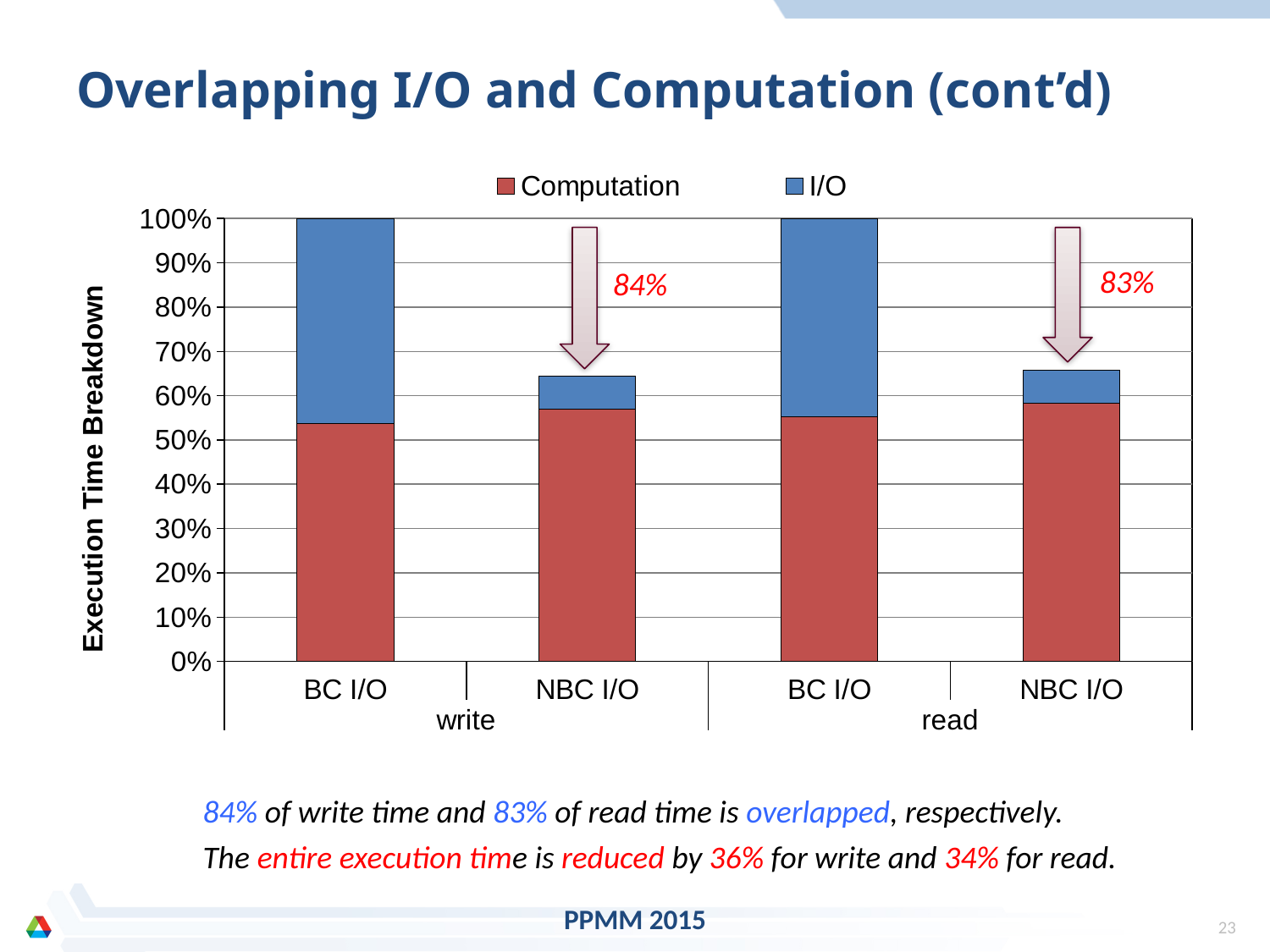
In the read group, which bar is taller overall, BC I/O or NBC I/O? BC I/O Is the total height of the NBC I/O bar in the read group greater or less than 60%? greater What are the two series named in the legend? Computation and I/O Is the Computation portion of the BC I/O bar in the write group greater or less than 50%? greater How many series does the chart's legend list? 2 What kind of chart is shown on the slide? Stacked bar chart Is the total height of the NBC I/O bar in the write group greater or less than 70%? less What is the title of the vertical axis? Execution Time Breakdown What percentage is printed next to the arrow above the NBC I/O bar in the read group? 83% What percentage is printed next to the arrow above the NBC I/O bar in the write group? 84% How many bars are plotted in the chart? 4 What is the total height of the BC I/O bar in the write group? 100%